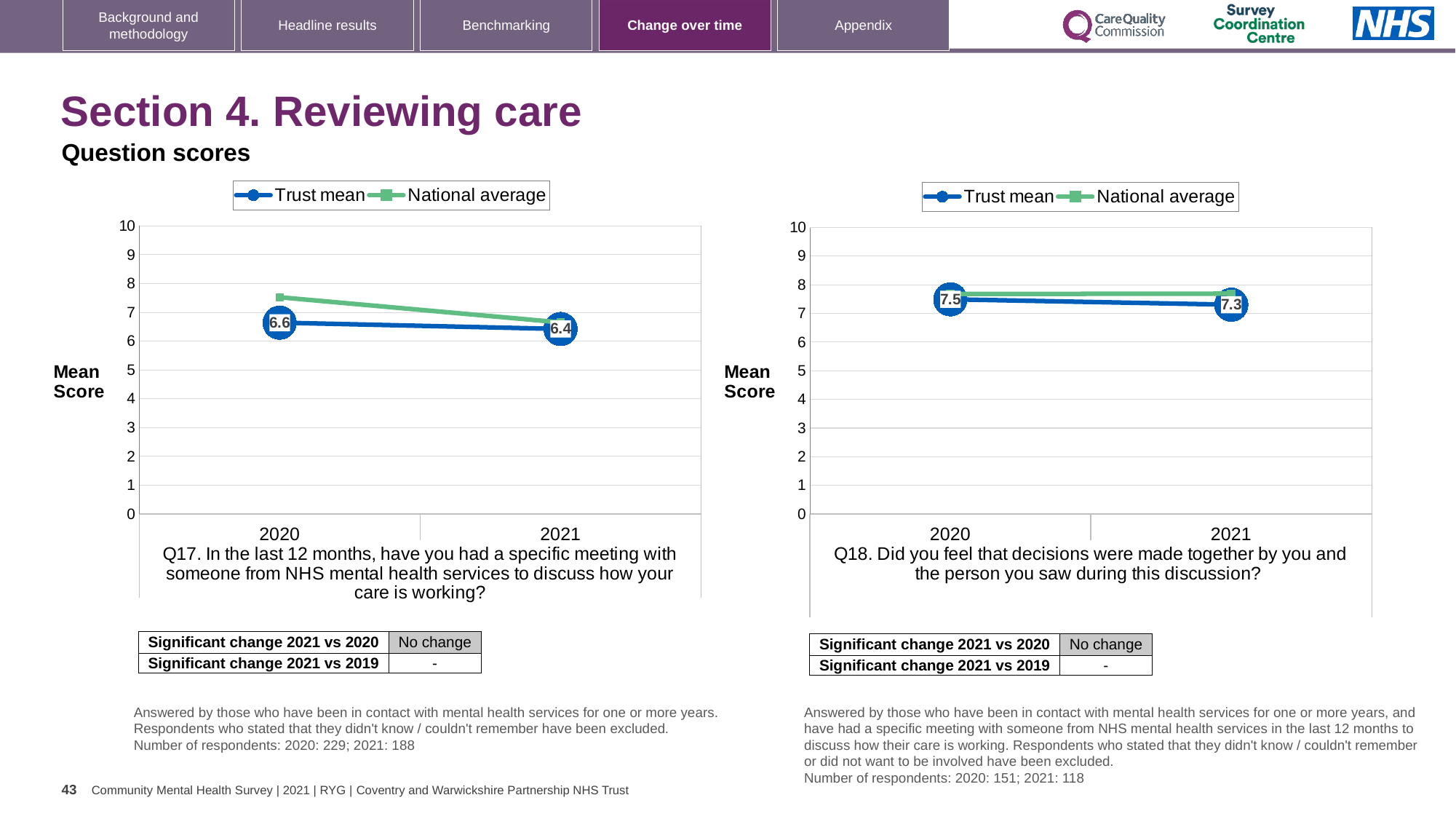
In the Q17 chart (left), what is the Trust mean for 2021? 6.4 How many series does the legend of the Q18 chart (right) list? 2 What type of chart is the Q17 chart (left)? line chart In the Q17 chart (left), is the National average for 2020 greater or less than 7? greater In the Q18 chart (right), is the National average for 2021 greater or less than 7? greater In the Q17 chart (left), what is the Trust mean for 2020? 6.6 In the Q17 chart (left), which is larger in 2020, the Trust mean or the National average? National average In the Q18 chart (right), what is the difference between the Trust mean in 2020 and 2021? 0.2 In the Q17 chart (left), does the Trust mean rise or fall from 2020 to 2021? fall In the Q18 chart (right), what is the Trust mean for 2021? 7.3 In the Q18 chart (right), what is the Trust mean for 2020? 7.5 In the Q17 chart (left), by how much did the Trust mean change from 2020 to 2021? 0.2